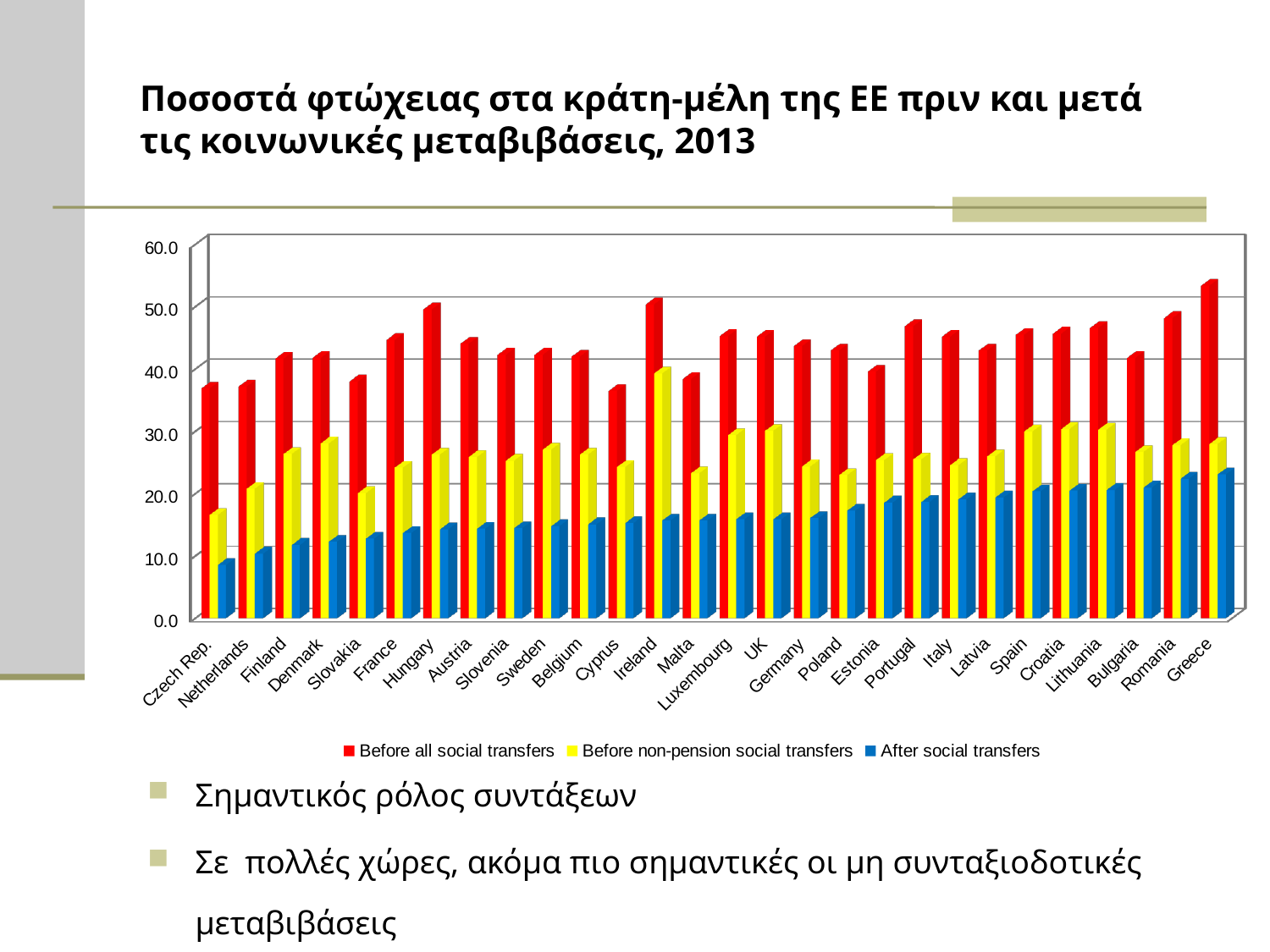
Which is larger: the 'Before non-pension social transfers' value for Ireland or for Malta? Ireland Which country has the highest value for 'Before non-pension social transfers'? Ireland Is the value for Greece in the 'Before all social transfers' series greater or less than 50? greater Which country has the highest value for 'Before all social transfers'? Greece Which country has the lowest value for 'After social transfers'? Czech Rep. Is the value for Ireland in the 'Before non-pension social transfers' series greater or less than 30? greater How many countries are shown on the x axis of the chart? 28 Which colour represents the 'After social transfers' series in the chart? Blue How many series does the chart's legend list? 3 Do the 'After social transfers' values generally rise or fall from left to right along the x axis? rise What kind of chart is shown on the slide? Bar chart Is the value for Netherlands in the 'Before all social transfers' series greater or less than 40? less